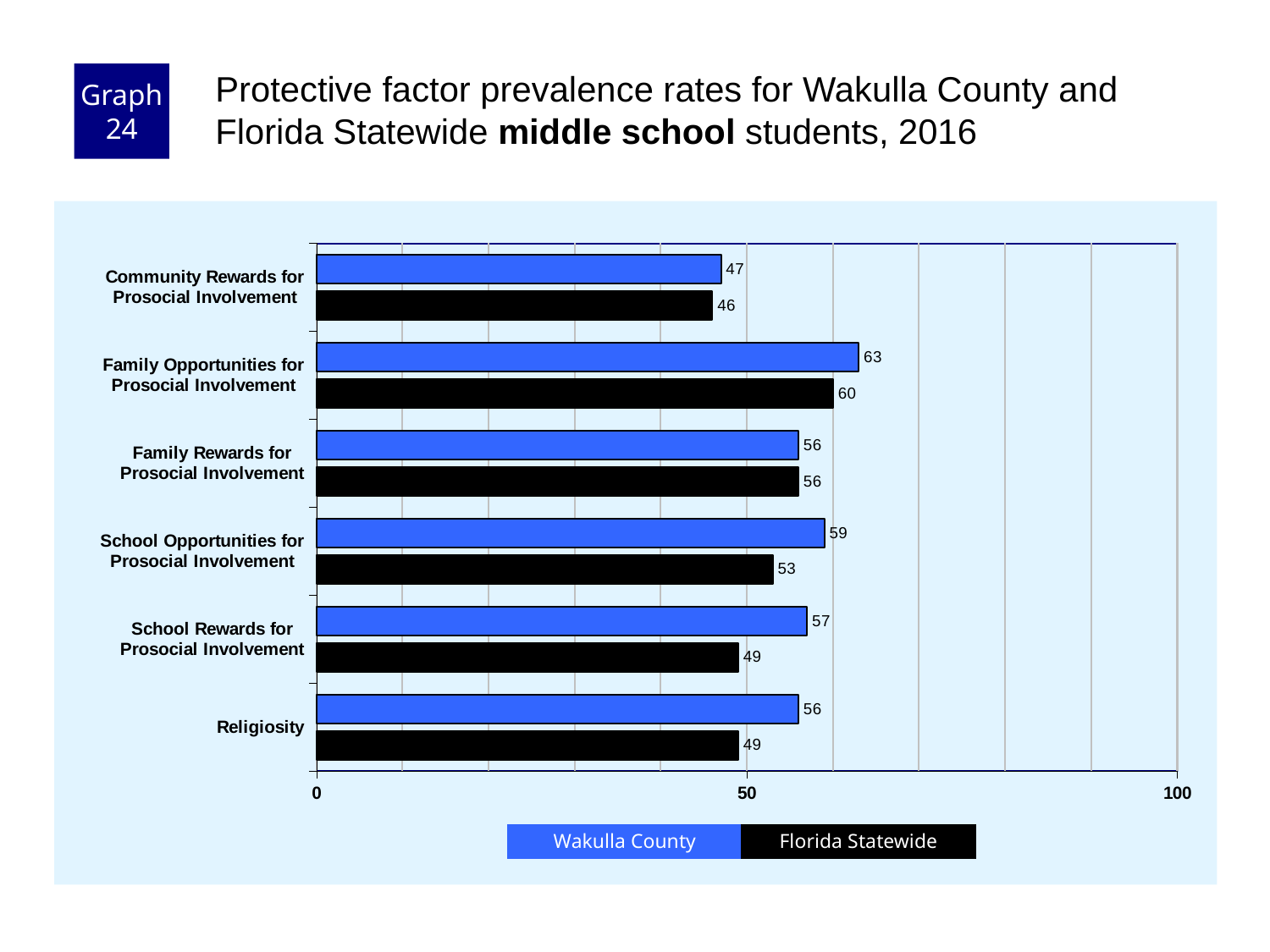
Is the Florida Statewide value for Community Rewards for Prosocial Involvement greater or less than 50? less What is the difference between the Wakulla County and Florida Statewide values for Religiosity? 7 Which category has the highest Wakulla County value? Family Opportunities for Prosocial Involvement What is the difference between the Wakulla County and Florida Statewide values for School Rewards for Prosocial Involvement? 8 Which category has the lowest Florida Statewide value? Community Rewards for Prosocial Involvement What is the Florida Statewide value for Community Rewards for Prosocial Involvement? 46 What is the Florida Statewide value for School Rewards for Prosocial Involvement? 49 For School Opportunities for Prosocial Involvement, which is larger: the Wakulla County value or the Florida Statewide value? Wakulla County What kind of chart is shown on the slide? bar chart How many series does the legend list? 2 How many categories are shown on the chart? 6 What is the Wakulla County value for Family Opportunities for Prosocial Involvement? 63